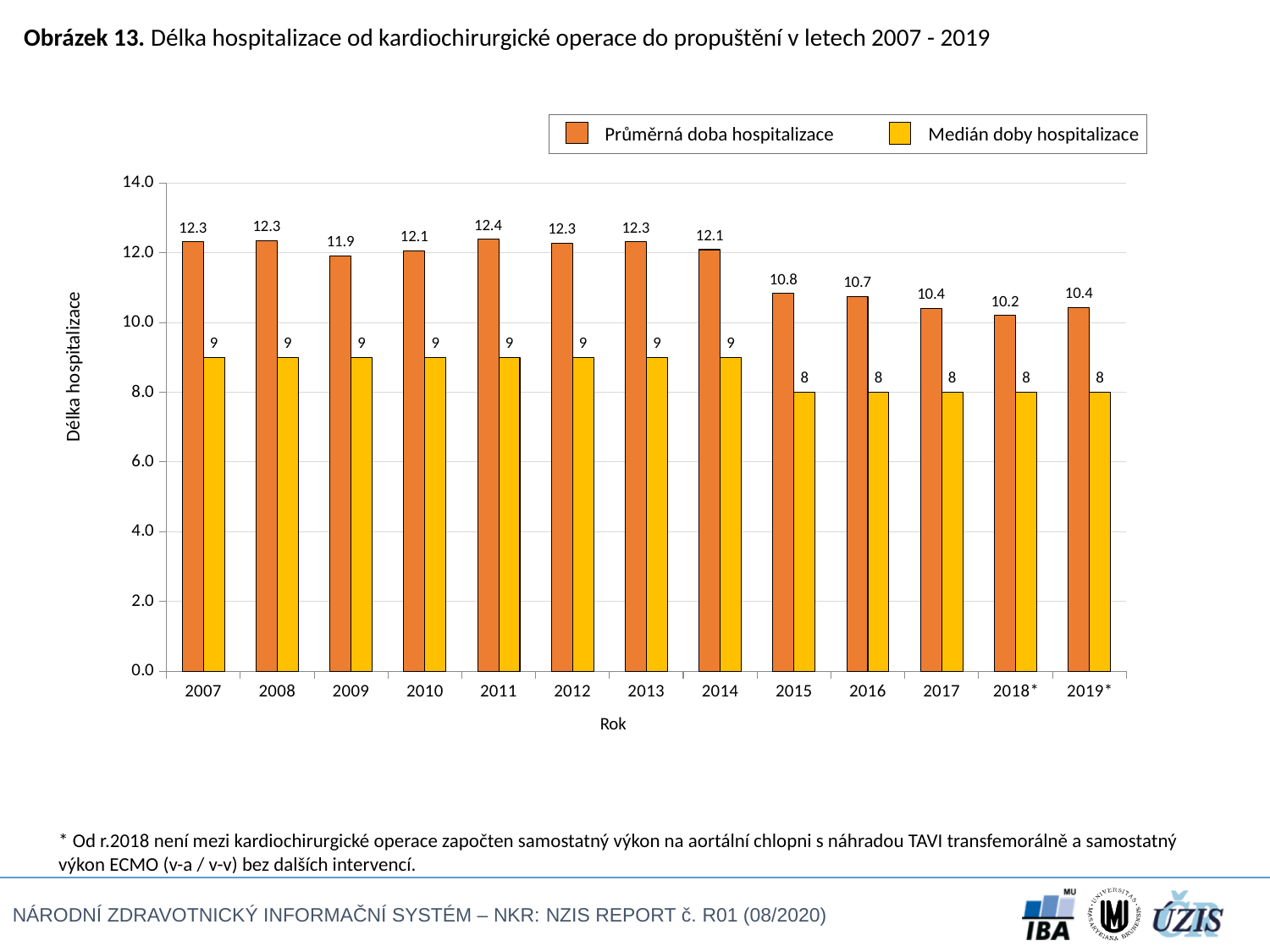
What kind of chart is shown on the slide? bar chart Is the average length of hospitalization in 2015 greater or less than 12.0? less Which is larger: the average length of hospitalization in 2009 or in 2010? 2010 How many years are shown on the x axis? 13 What is the median length of hospitalization (Medián doby hospitalizace) in 2016? 8 How many series does the legend list? 2 What is the difference between the average length of hospitalization in 2007 and in 2019*? 1.9 What is the average length of hospitalization (Průměrná doba hospitalizace) in 2018*? 10.2 In which year is the average length of hospitalization (Průměrná doba hospitalizace) highest? 2011 What is the difference between the median length of hospitalization in 2014 and in 2015? 1 What is the average length of hospitalization (Průměrná doba hospitalizace) in 2011? 12.4 In which year is the average length of hospitalization (Průměrná doba hospitalizace) lowest? 2018*